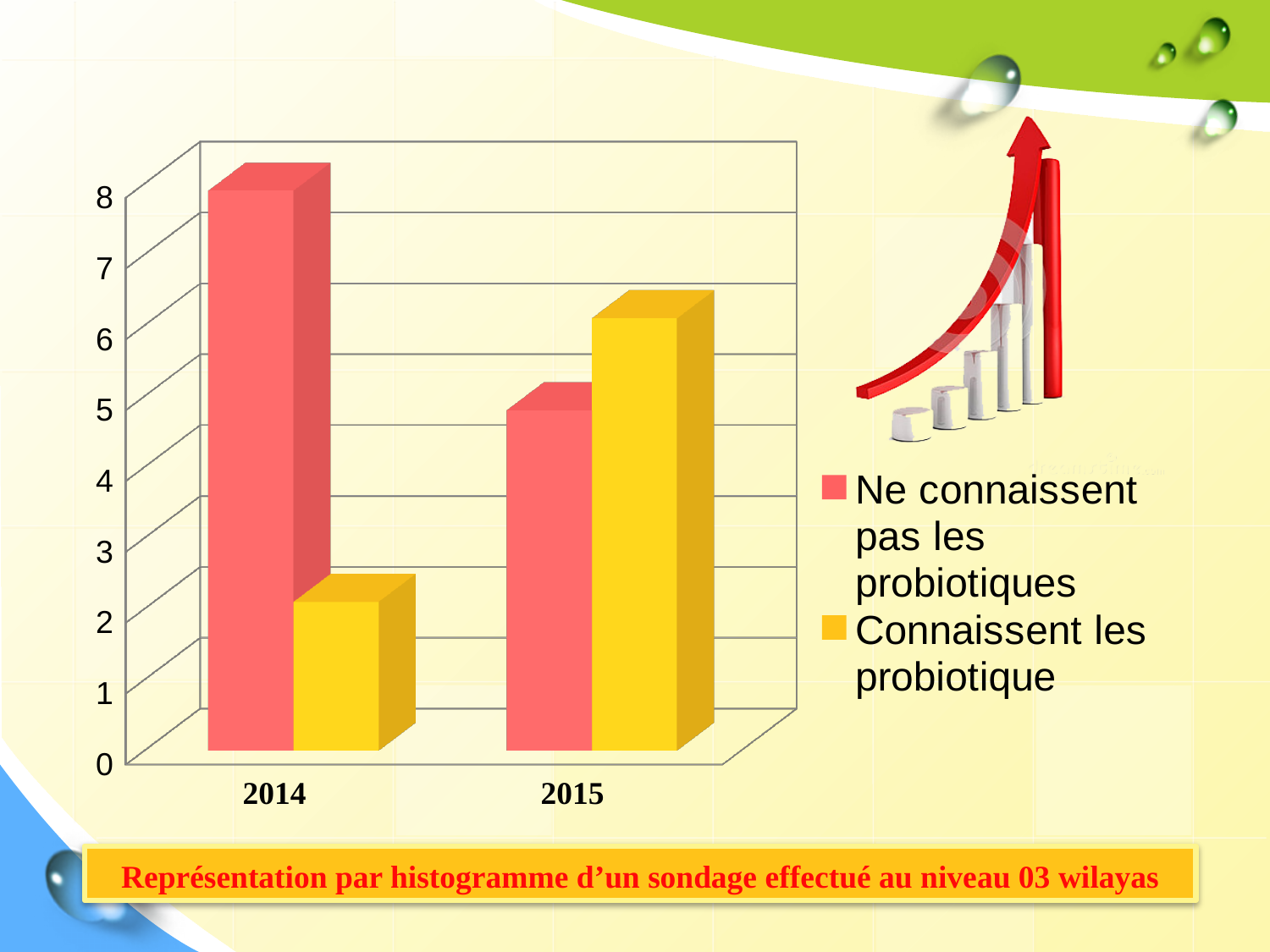
Is the value for 'Ne connaissent pas les probiotiques' in 2014 greater or less than 7? greater Is the value for 'Ne connaissent pas les probiotiques' in 2015 greater or less than 7? less Is the value for 'Connaissent les probiotique' in 2015 greater or less than 5? greater How many series does the legend list? 2 Which series is shown in yellow? Connaissent les probiotique Does the value for 'Connaissent les probiotique' rise or fall from 2014 to 2015? rise Which series is shown in red? Ne connaissent pas les probiotiques What kind of chart is shown on the slide? bar chart How many categories are shown on the x axis? 2 In 2014, which series has the larger value, 'Ne connaissent pas les probiotiques' or 'Connaissent les probiotique'? Ne connaissent pas les probiotiques In 2015, which series has the larger value, 'Ne connaissent pas les probiotiques' or 'Connaissent les probiotique'? Connaissent les probiotique